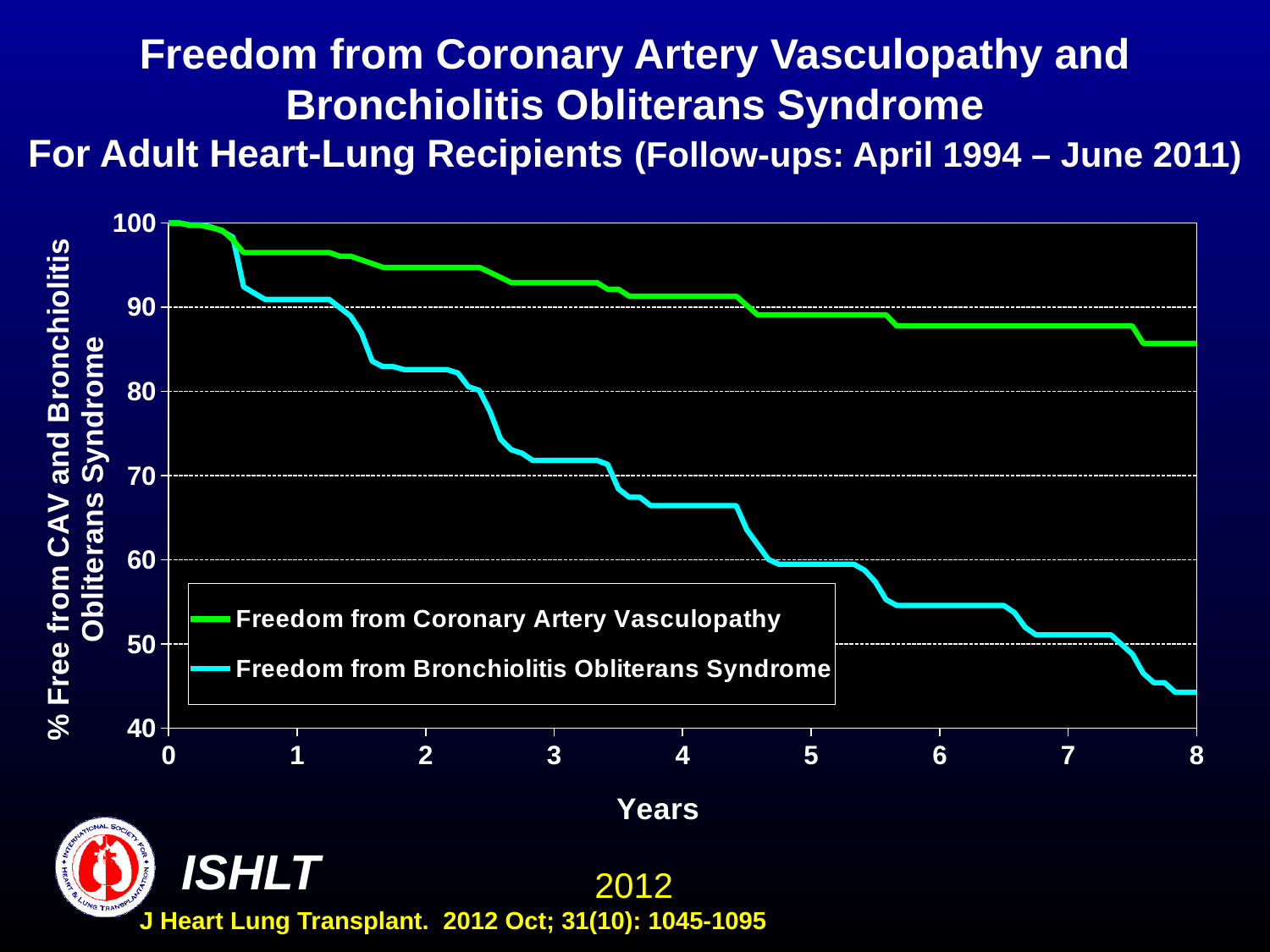
Is the value for Freedom from Bronchiolitis Obliterans Syndrome at year 4 greater or less than 70? less What is the label of the x axis? Years Do the values of the Freedom from Bronchiolitis Obliterans Syndrome line rise or fall as years increase? fall How many series does the legend list? 2 Do the values of the Freedom from Coronary Artery Vasculopathy line rise or fall as years increase? fall At year 8, which series has the higher value, Freedom from Coronary Artery Vasculopathy or Freedom from Bronchiolitis Obliterans Syndrome? Freedom from Coronary Artery Vasculopathy Is the value for Freedom from Bronchiolitis Obliterans Syndrome at year 8 greater or less than 50? less Which series is plotted in green? Freedom from Coronary Artery Vasculopathy What kind of chart is shown on the slide? line chart Is the value for Freedom from Coronary Artery Vasculopathy at year 1 greater or less than 90? greater